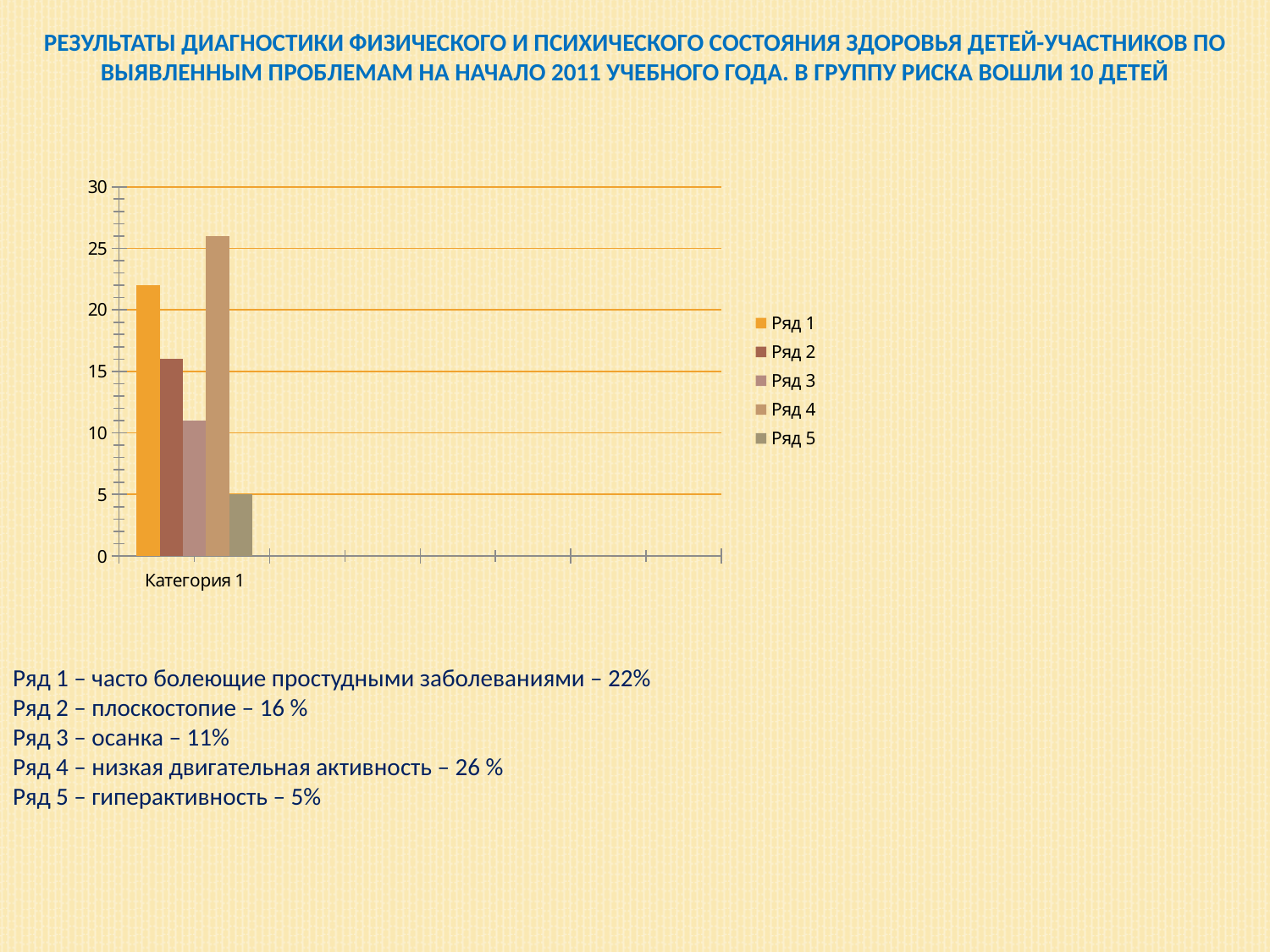
How many categories are shown on the x axis of the chart? 1 How many series does the chart legend list? 5 Which series has the highest bar in the chart? Ряд 4 According to the text below the chart, what percentage corresponds to Ряд 4 (низкая двигательная активность)? 26 % What is the label of the single category on the x axis? Категория 1 What value does the bar for Ряд 5 reach on the y axis? 5 Which series has the lowest bar in the chart? Ряд 5 Is the value for Ряд 3 greater or less than 15? less Is the value for Ряд 1 greater or less than 20? greater What kind of chart is shown on the slide? bar chart Which bar is taller, Ряд 1 or Ряд 2? Ряд 1 Is the value for Ряд 4 greater or less than 25? greater